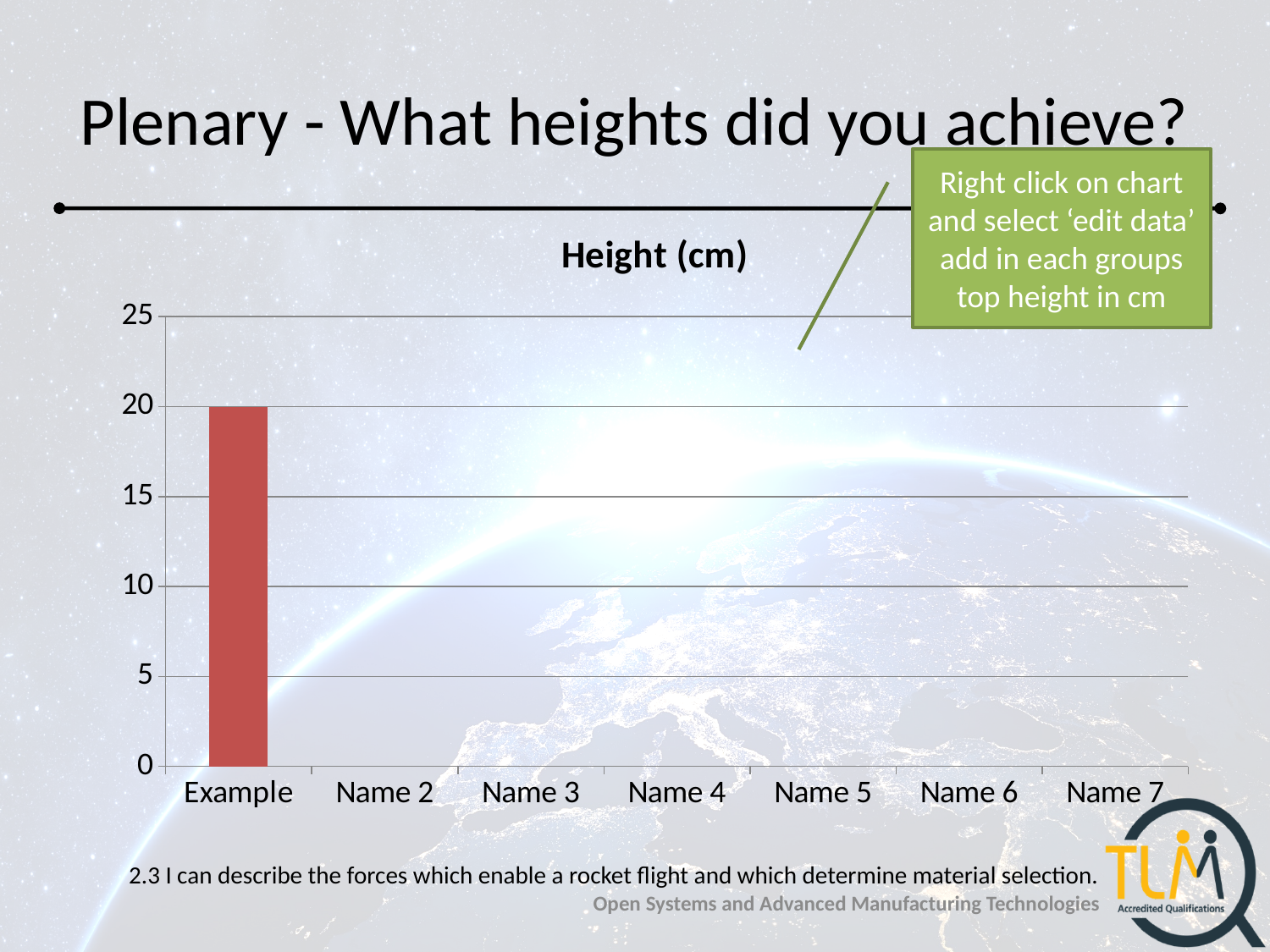
Which category has the highest value in the chart? Example What kind of chart is shown on the slide? bar chart What is the label of the first category on the x axis? Example What is the highest value shown on the y axis of the chart? 25 How many categories are shown along the x axis of the chart? 7 What is the value for Example in the chart? 20 What is the label of the last category on the x axis? Name 7 How many categories in the chart have a visible bar plotted? 1 Is the value for Example greater or less than 15? greater What colour is the bar for Example? red What is the title of the chart? Height (cm) Is the value for Example greater or less than 25? less